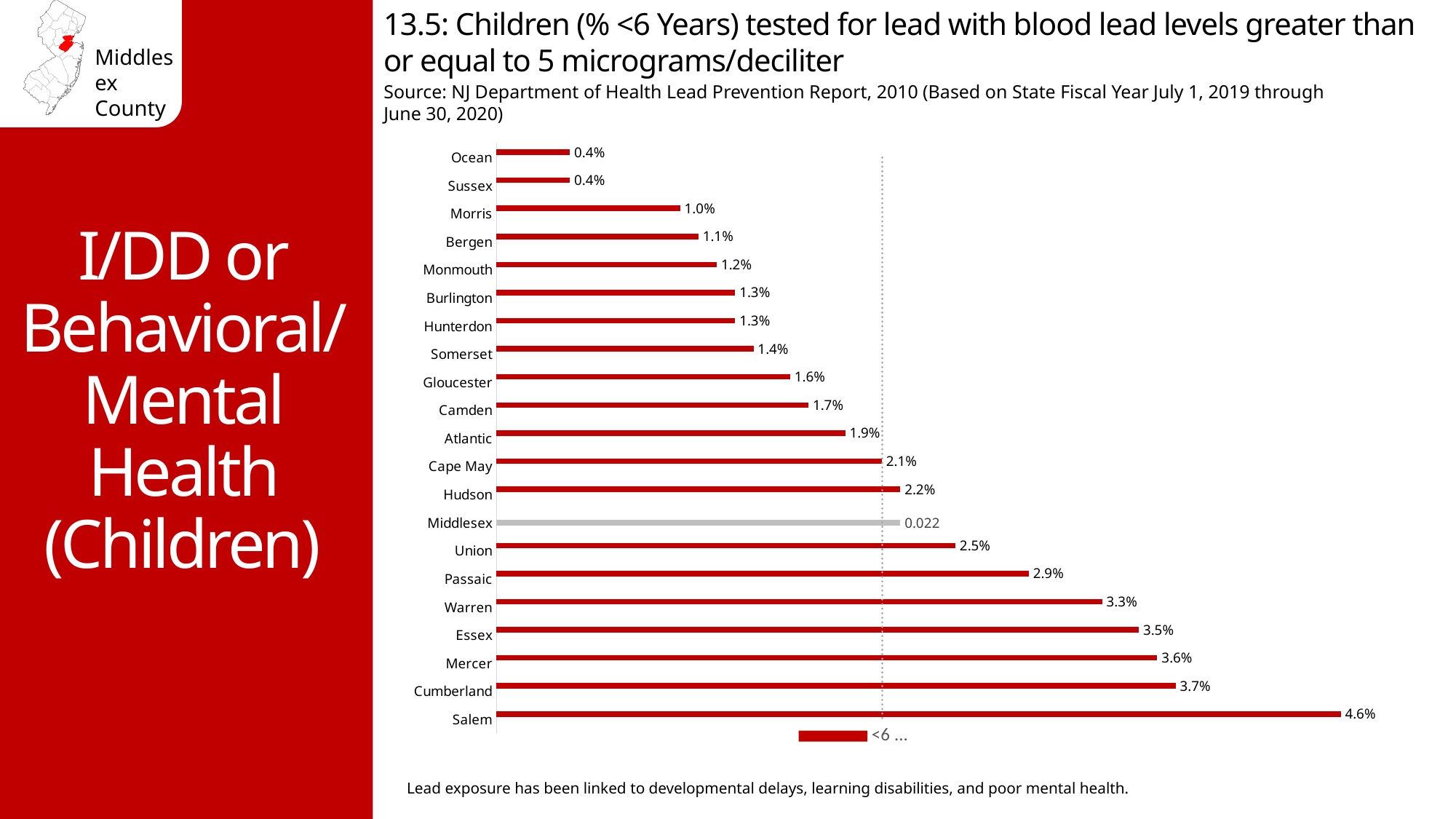
What colour is the bar for Middlesex? Gray Do the values increase or decrease going from the top bar to the bottom bar? Increase What is the value for Ocean? 0.4% Which has a larger value, Morris or Gloucester? Gloucester How many counties are shown in the chart? 21 What is the value for Salem? 4.6% What is the data label shown for Middlesex? 0.022 Which county has the highest value? Salem Which has a larger value, Essex or Warren? Essex What is the value for Passaic? 2.9% What is the difference between the values for Salem and Cumberland? 0.9 percentage points What kind of chart is shown on the slide? Bar chart